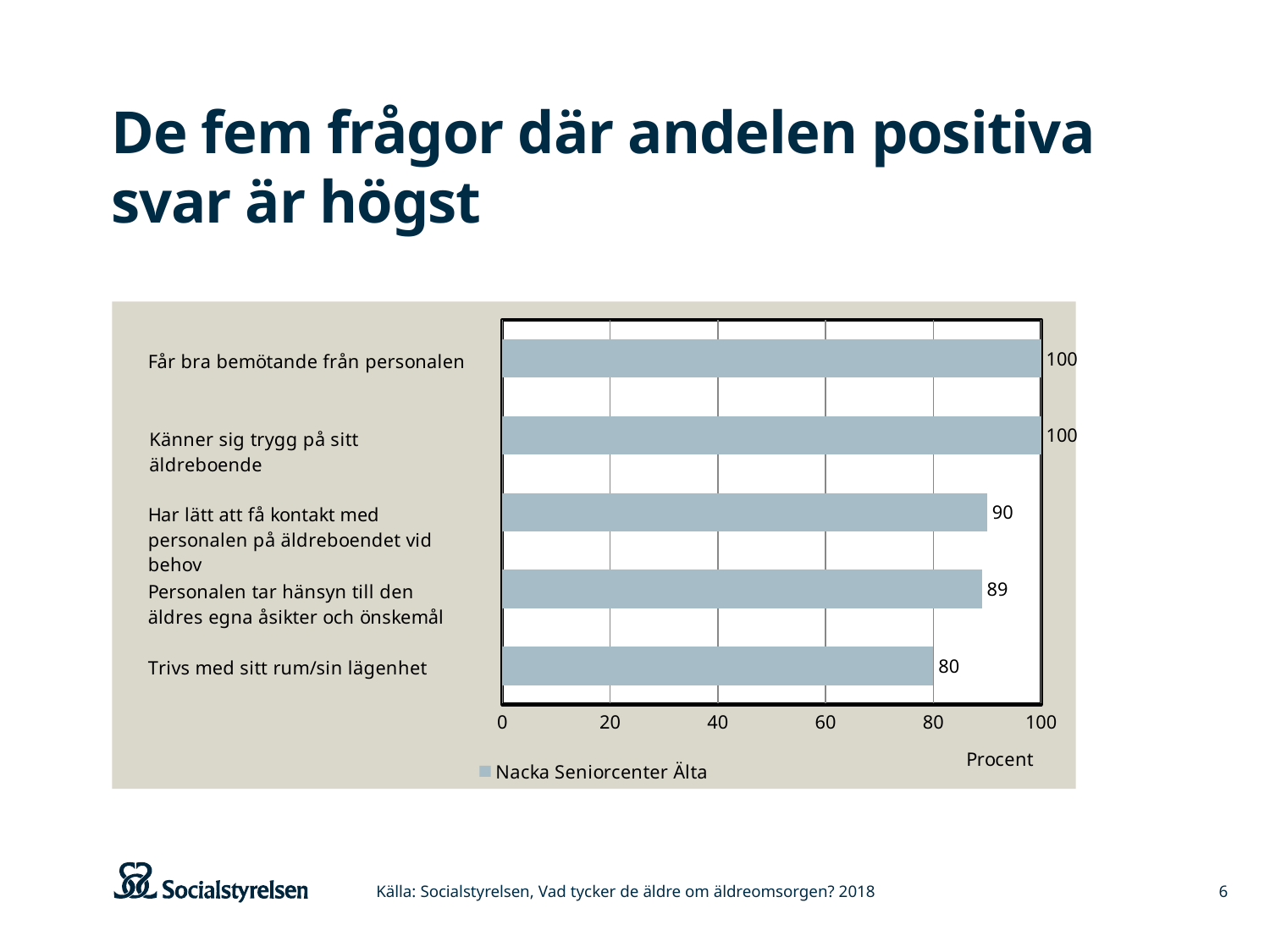
What is the name of the series shown in the legend? Nacka Seniorcenter Älta What kind of chart is shown on the slide? Bar chart What is the value for "Har lätt att få kontakt med personalen på äldreboendet vid behov"? 90 Which is larger: the value for "Känner sig trygg på sitt äldreboende" or the value for "Trivs med sitt rum/sin lägenhet"? Känner sig trygg på sitt äldreboende What is the difference between the values for "Har lätt att få kontakt med personalen på äldreboendet vid behov" and "Personalen tar hänsyn till den äldres egna åsikter och önskemål"? 1 What is the value for "Personalen tar hänsyn till den äldres egna åsikter och önskemål"? 89 What is the value for "Trivs med sitt rum/sin lägenhet"? 80 How many series does the legend list? 1 How many categories are shown in the chart? 5 Which category has the lowest value? Trivs med sitt rum/sin lägenhet What is the value for "Känner sig trygg på sitt äldreboende"? 100 What is the difference between the values for "Får bra bemötande från personalen" and "Trivs med sitt rum/sin lägenhet"? 20